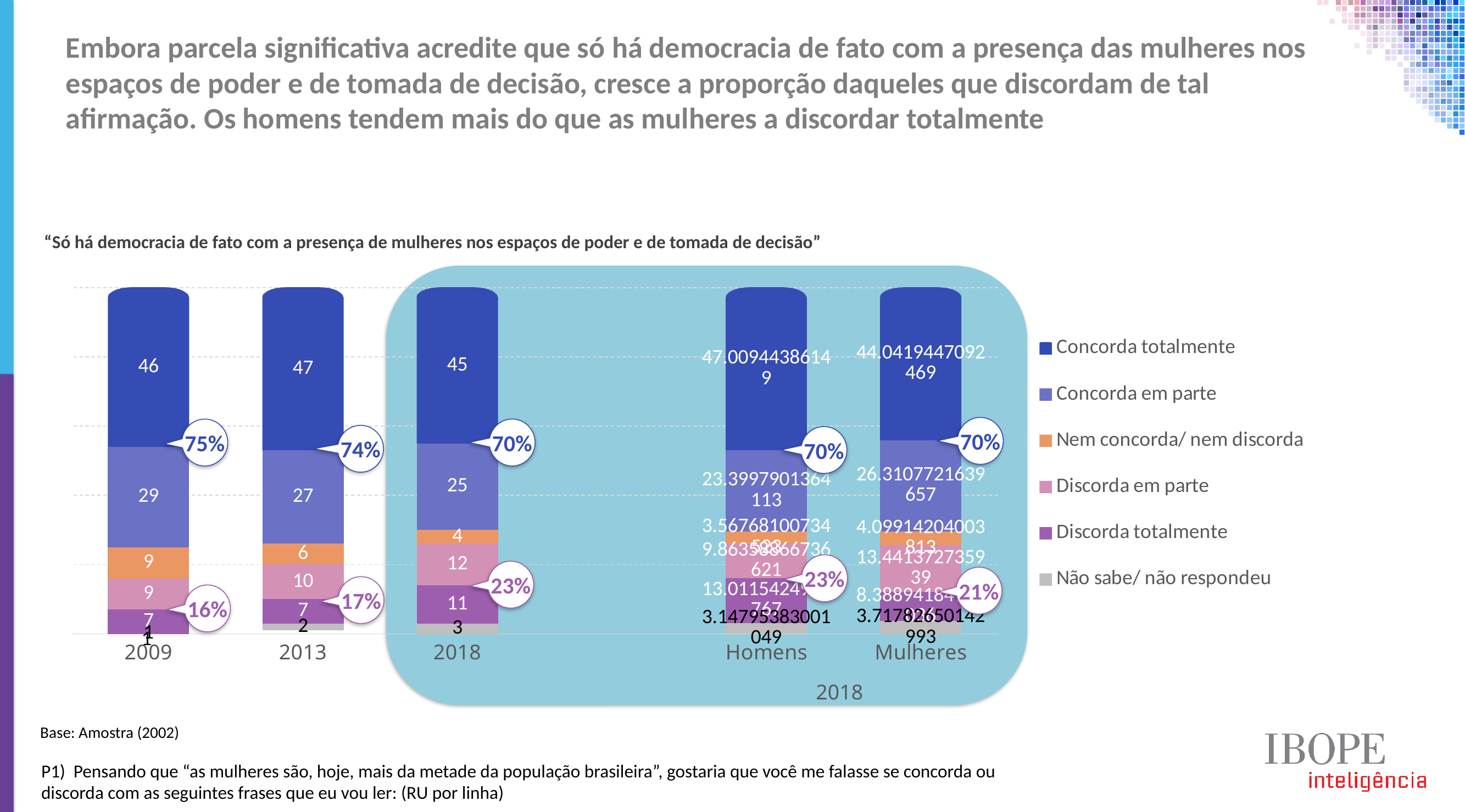
Among 2009, 2013 and 2018, which year has the highest value for "Concorda totalmente"? 2013 What is the difference between the "Concorda em parte" values for 2009 and 2018? 4 How many series does the legend list? 6 What is the value for "Discorda em parte" in 2018? 12 Which is larger, the "Discorda totalmente" value for 2009 or for 2018? 2018 How many bars are plotted in the chart? 5 What combined agreement percentage is shown in the callout for 2009? 75% What is the value for "Nem concorda/ nem discorda" in 2009? 9 What combined disagreement percentage is shown in the callout for Mulheres? 21% What kind of chart is shown on the slide? Stacked bar chart What is the value for "Concorda totalmente" in 2013? 47 Does the "Concorda em parte" value rise or fall from 2009 to 2018? Fall